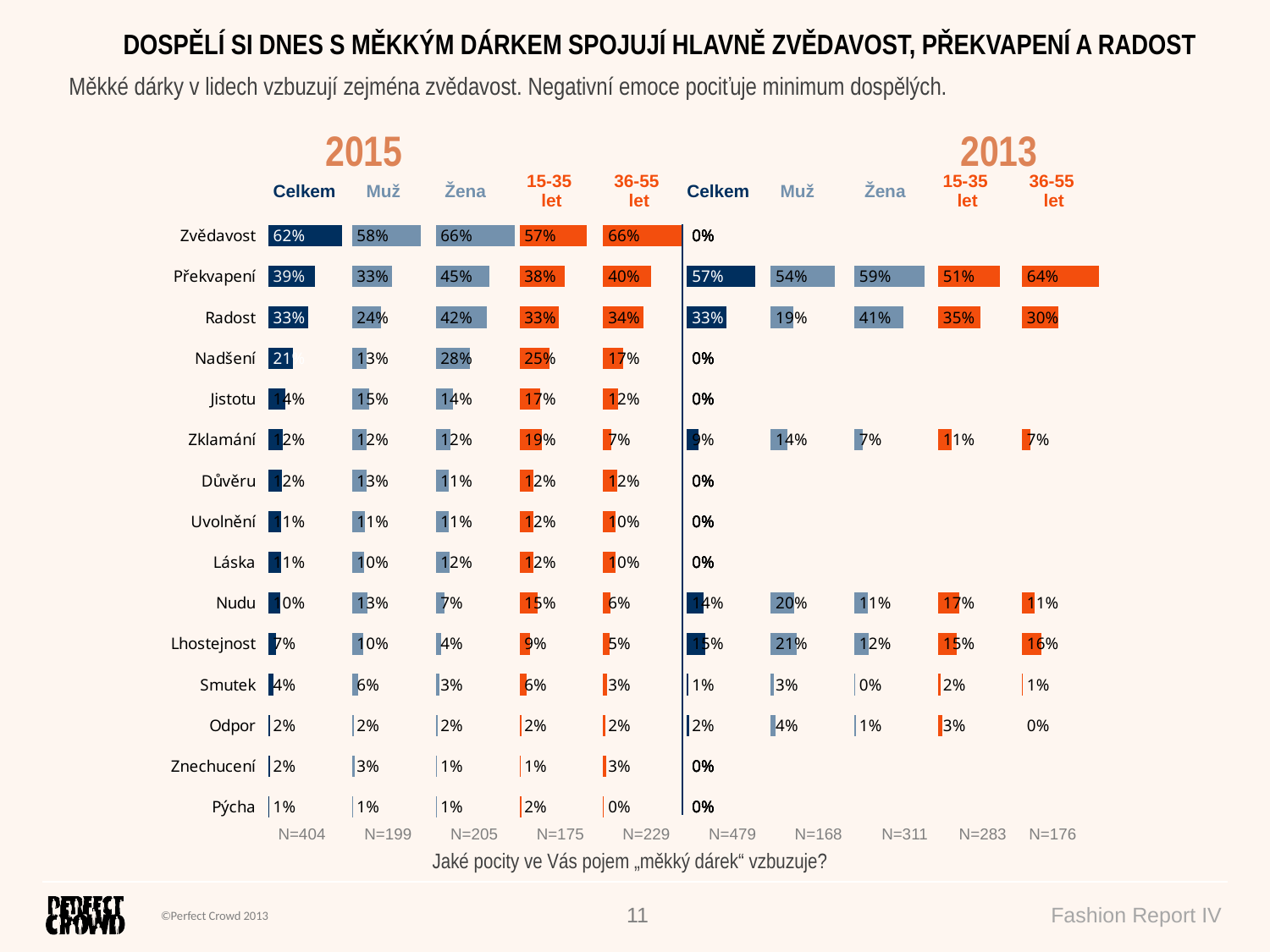
In the 2013 Celkem chart, what is the difference between Překvapení and Radost? 24% In the 2013 Muž chart, what is the value for Lhostejnost? 21% What kind of chart is used on this slide? Bar chart In the 2015 Žena chart, what is the value for Překvapení? 45% In the 2015 Celkem chart, which category has the lowest value? Pýcha In the 2013 36-55 let chart, what is the value for Překvapení? 64% In the 2015 Celkem chart, what is the value for Zvědavost? 62% In the 2015 Muž chart, what is the difference between Zvědavost and Překvapení? 25% What is the sample size (N) shown under the 2015 Celkem chart? N=404 How many emotion categories are listed on the left of the charts? 15 In the 2015 Celkem chart, which category has the highest value? Zvědavost Which is larger: Radost in the 2015 Žena chart or Radost in the 2015 Muž chart? 2015 Žena